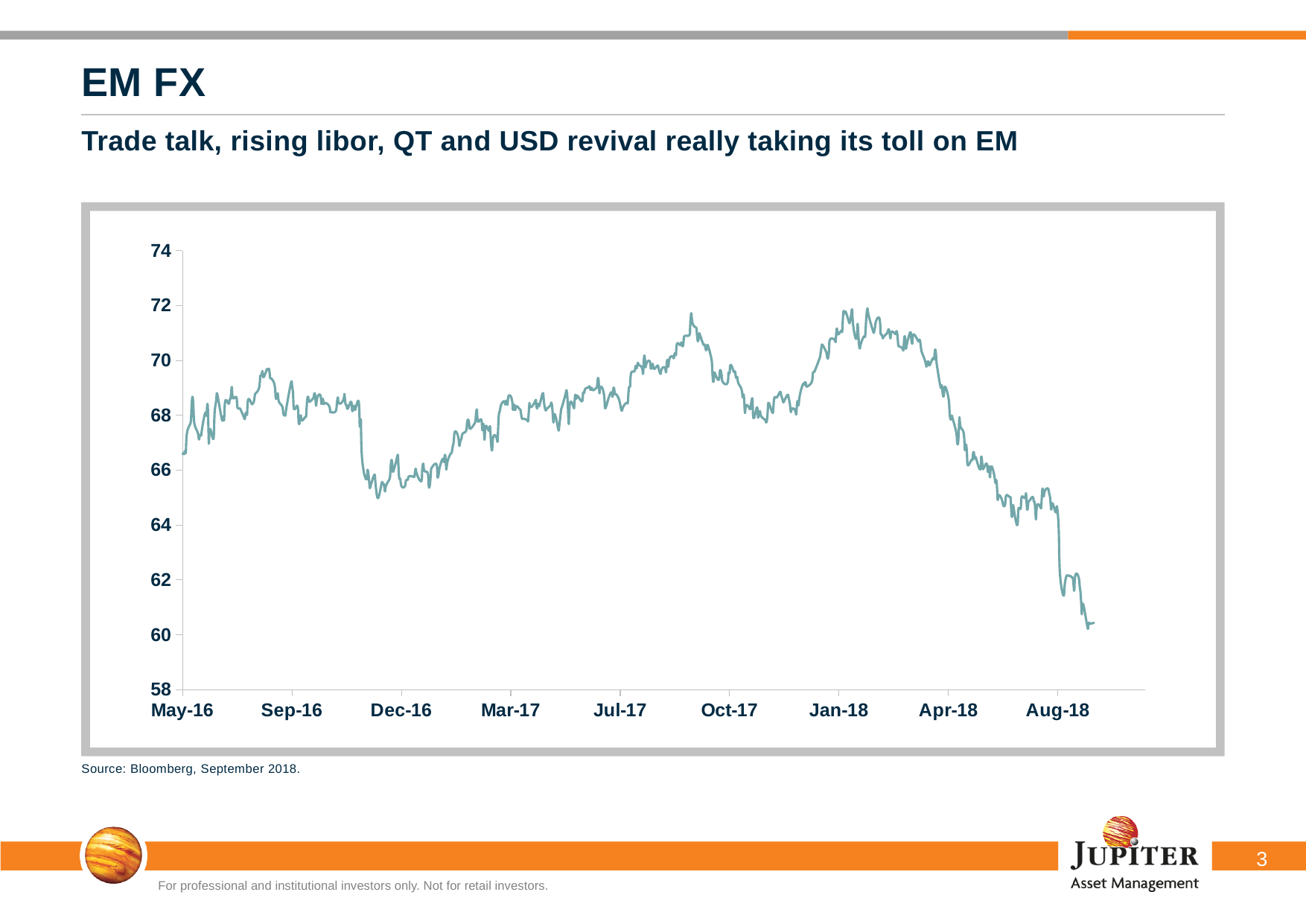
How many date labels are shown on the x axis? 9 Is the value at the end of the series (after Aug-18) greater or less than 62? less Is the value at Apr-18 greater or less than 68? greater Which is larger, the value at Jul-17 or the value at Aug-18? Jul-17 Overall, does the line rise or fall between May-16 and the end of the series in 2018? Fall Around which x-axis label does the line reach its lowest point? After Aug-18 (end of series) Is the value at May-16 greater or less than 68? less Which is larger, the value at Jan-18 or the value at Aug-18? Jan-18 What is the source cited for the chart? Bloomberg, September 2018 What kind of chart is shown on the slide? Line chart